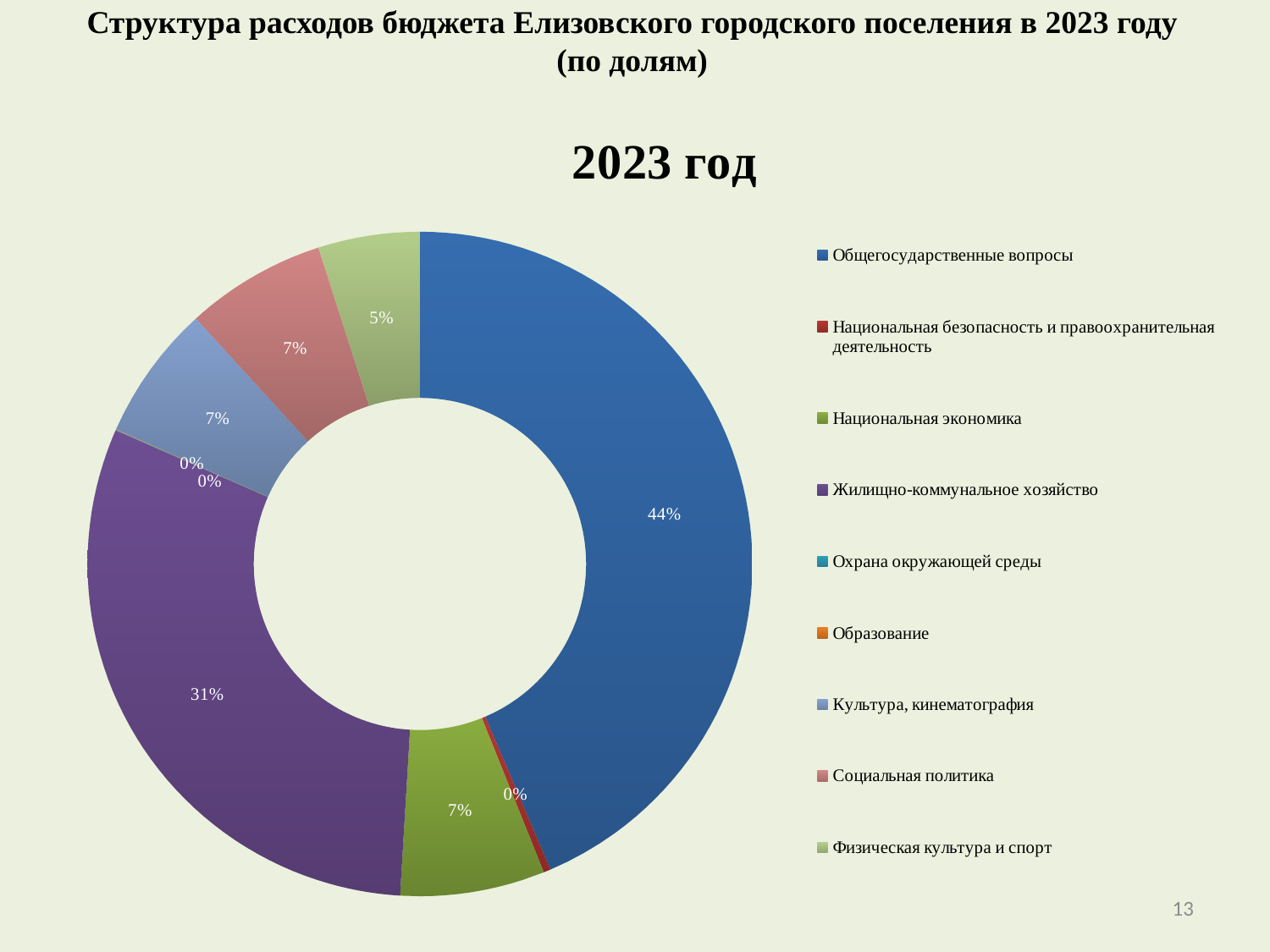
Which category has the largest share of the budget expenditures? Общегосударственные вопросы What share is labelled for Социальная политика? 7% How many entries does the legend list? 9 Which is larger: the share for Жилищно-коммунальное хозяйство or the share for Культура, кинематография? Жилищно-коммунальное хозяйство What is the chart's title? 2023 год What share is labelled for Жилищно-коммунальное хозяйство? 31% What type of chart is shown on the slide? Doughnut (pie) chart What is the difference in percentage points between Общегосударственные вопросы and Жилищно-коммунальное хозяйство? 13 percentage points What share is labelled for Физическая культура и спорт? 5% What colour is the slice for Общегосударственные вопросы? Blue What share is labelled for Национальная экономика? 7% What share of expenditures is labelled for Общегосударственные вопросы? 44%